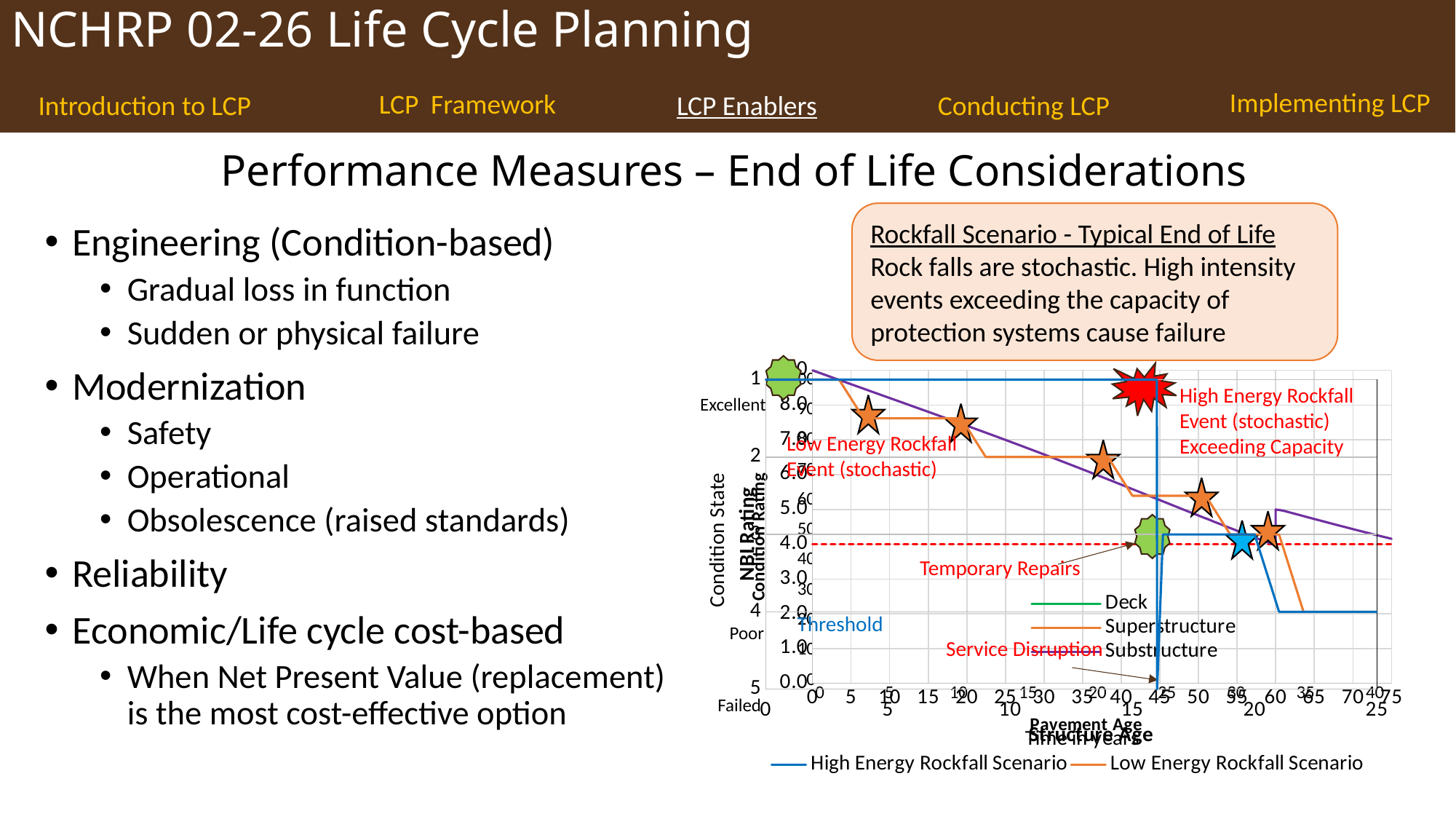
What kind of chart is shown on the right of the slide? line chart What does the dashed red horizontal line on the chart represent, according to its label? Threshold How many series does the legend inside the chart area (Deck, Superstructure, Substructure) list? 3 Does the Low Energy Rockfall Scenario line rise or fall as time increases along the x axis? fall How many series does the legend at the bottom of the chart list? 2 What are the two series named in the legend at the bottom of the chart? High Energy Rockfall Scenario and Low Energy Rockfall Scenario